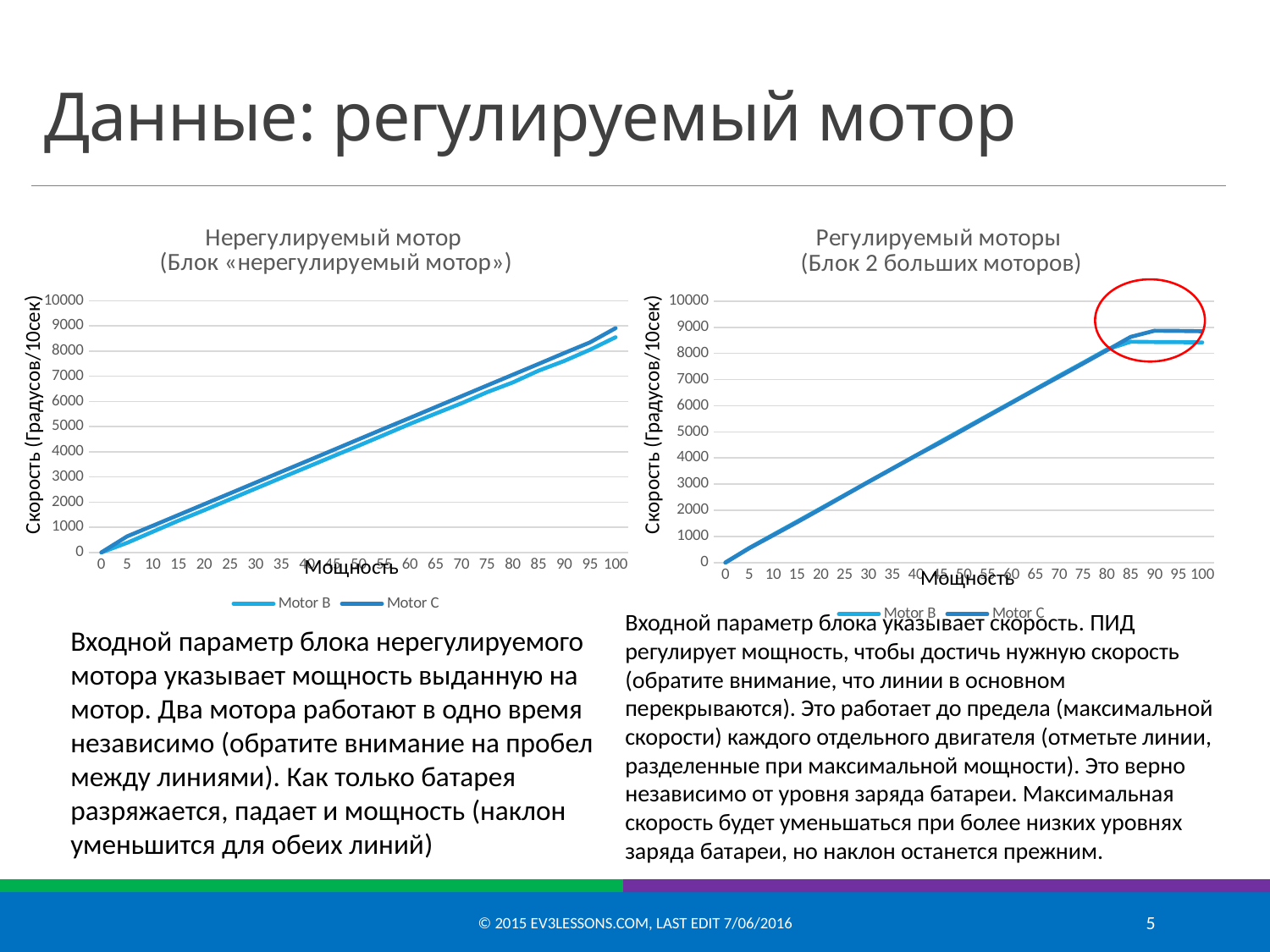
What is the y-axis title of the right chart «Регулируемый моторы»? Скорость (Градусов/10сек) What kind of chart is the right chart titled «Регулируемый моторы»? line chart In the left chart «Нерегулируемый мотор», do the values for Motor C rise or fall as Мощность increases from 0 to 100? rise In the left chart «Нерегулируемый мотор», is the value for Motor B at Мощность 50 greater or less than 5000? less In the right chart «Регулируемый моторы», which series has the higher value at Мощность 100, Motor B or Motor C? Motor C In the right chart «Регулируемый моторы», do the values for Motor B rise or fall as Мощность increases from 0 to 85? rise In the right chart «Регулируемый моторы», is the value for Motor B at Мощность 100 greater or less than 9000? less What kind of chart is the left chart titled «Нерегулируемый мотор»? line chart In the left chart «Нерегулируемый мотор», is the value for Motor C at Мощность 100 greater or less than 8000? greater How many series does the legend of the left chart «Нерегулируемый мотор» list? 2 In the left chart «Нерегулируемый мотор», which series has the higher value at Мощность 100, Motor B or Motor C? Motor C How many series does the legend of the right chart «Регулируемый моторы» list? 2